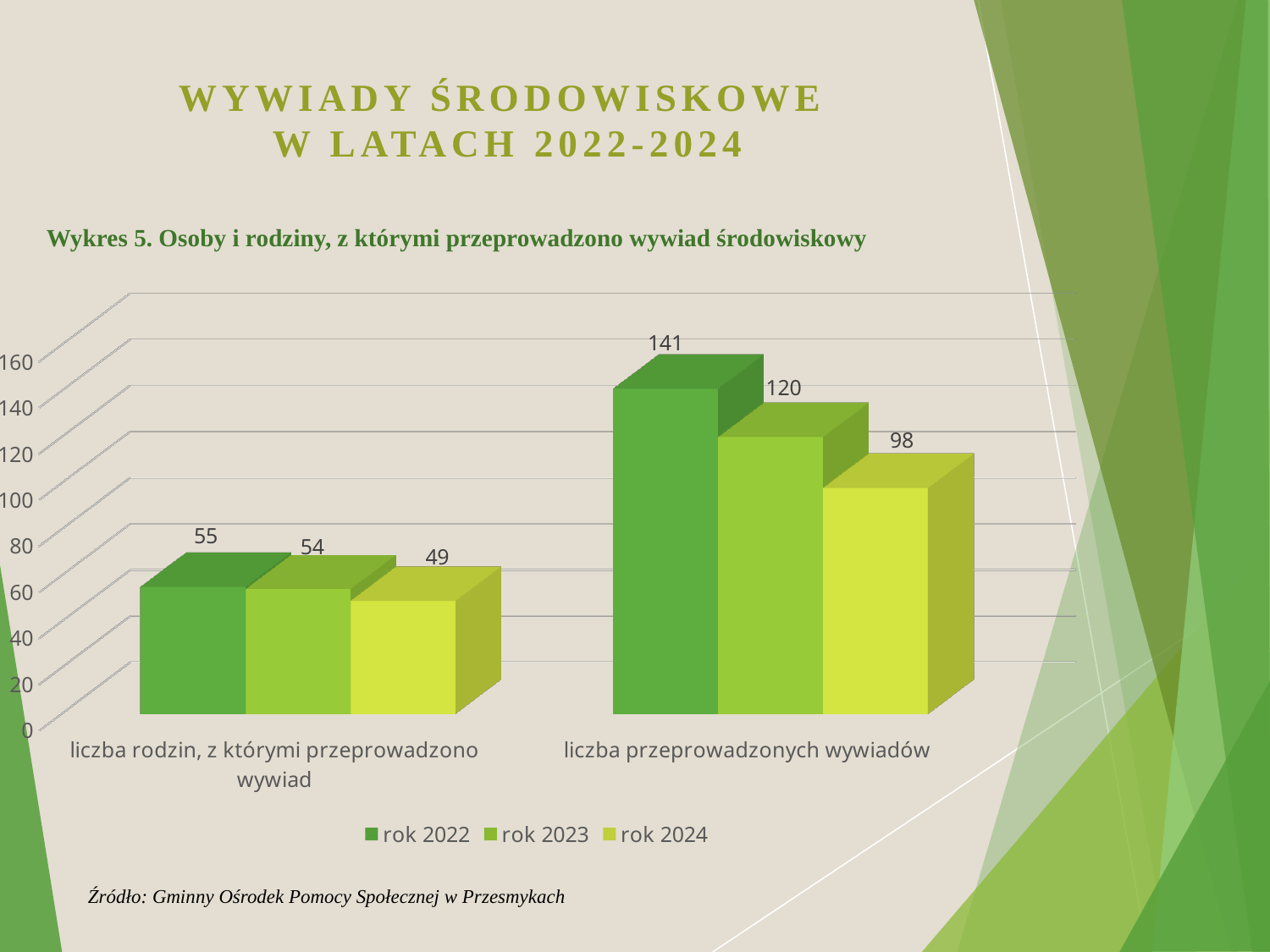
What is the difference between the rok 2022 and rok 2023 values in the category 'liczba rodzin, z którymi przeprowadzono wywiad'? 1 How many series does the legend list? 3 Which year has the highest value in the category 'liczba przeprowadzonych wywiadów'? rok 2022 Which year has the lowest value in the category 'liczba rodzin, z którymi przeprowadzono wywiad'? rok 2024 How many categories are shown on the x axis? 2 Do the values for 'liczba przeprowadzonych wywiadów' rise or fall from rok 2022 to rok 2024? fall What is the value for rok 2024 in the category 'liczba rodzin, z którymi przeprowadzono wywiad'? 49 Which is larger: the rok 2023 value for 'liczba przeprowadzonych wywiadów' or the rok 2024 value for 'liczba przeprowadzonych wywiadów'? rok 2023 What is the value for rok 2023 in the category 'liczba przeprowadzonych wywiadów'? 120 What is the value for rok 2022 in the category 'liczba przeprowadzonych wywiadów'? 141 What kind of chart is shown on the slide? bar chart What is the difference between the rok 2022 and rok 2024 values in the category 'liczba przeprowadzonych wywiadów'? 43